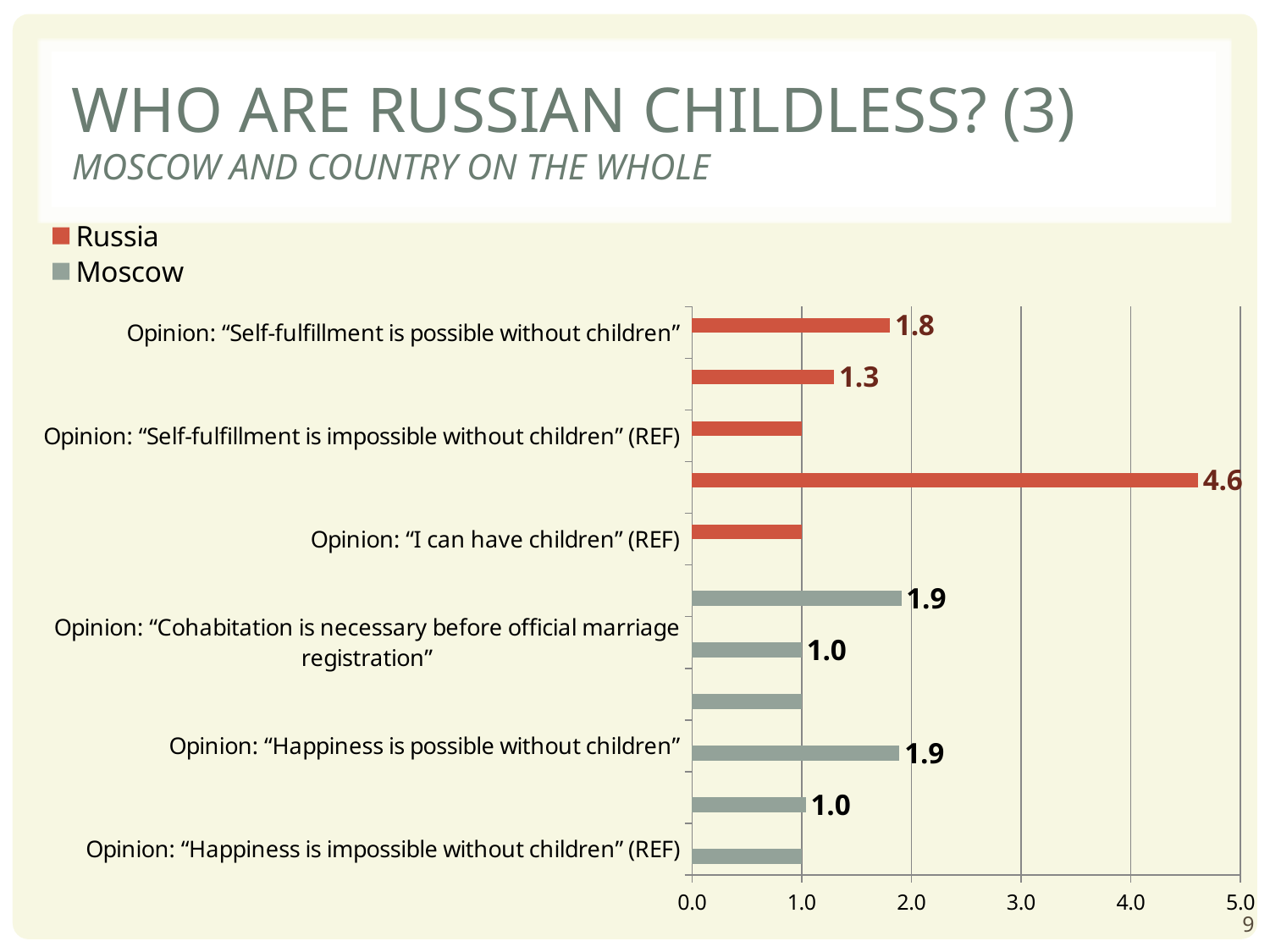
What is the value of the bar for the opinion "Self-fulfillment is possible without children"? 1.8 Which series is shown in red in the legend? Russia How many series does the legend list? 2 Which is larger: the bar labelled 1.8 or the bar labelled 1.3? 1.8 What is the highest value labelled on the chart? 4.6 Is the longest bar on the chart greater or less than 4.0? greater What is the value of the bar for the opinion "Cohabitation is necessary before official marriage registration"? 1.0 What is the value of the bar for the opinion "Happiness is possible without children"? 1.9 How many bars are plotted on the chart? 11 What is the maximum value shown on the horizontal axis? 5.0 What kind of chart is shown on the slide? bar chart What is the difference between the bar labelled 4.6 and the bar labelled 1.8? 2.8